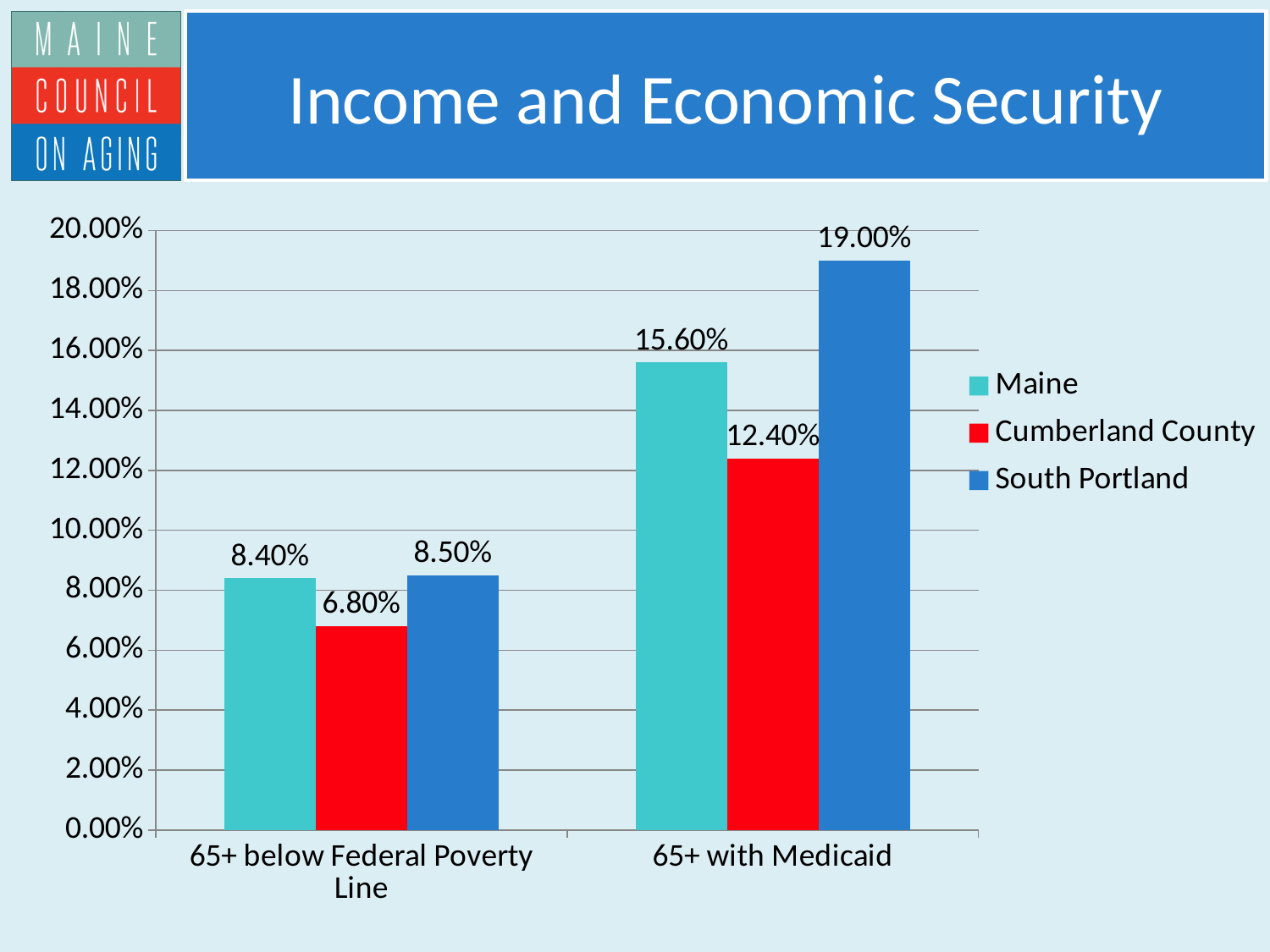
What is the value for Maine in the '65+ below Federal Poverty Line' category? 8.40% What kind of chart is shown on the slide? Bar chart How many categories are shown on the x axis? 2 Which series has the lowest value in the '65+ below Federal Poverty Line' category? Cumberland County Which series has the highest value in the '65+ with Medicaid' category? South Portland What is the value for Cumberland County in the '65+ with Medicaid' category? 12.40% What is the difference between Maine and Cumberland County in the '65+ below Federal Poverty Line' category? 1.60% What is the difference between South Portland and Maine in the '65+ with Medicaid' category? 3.40% Which is larger: Maine's value for '65+ with Medicaid' or Cumberland County's value for '65+ with Medicaid'? Maine What is the value for South Portland in the '65+ with Medicaid' category? 19.00% Is the value for South Portland in the '65+ with Medicaid' category greater or less than 18.00%? greater How many series does the legend list? 3